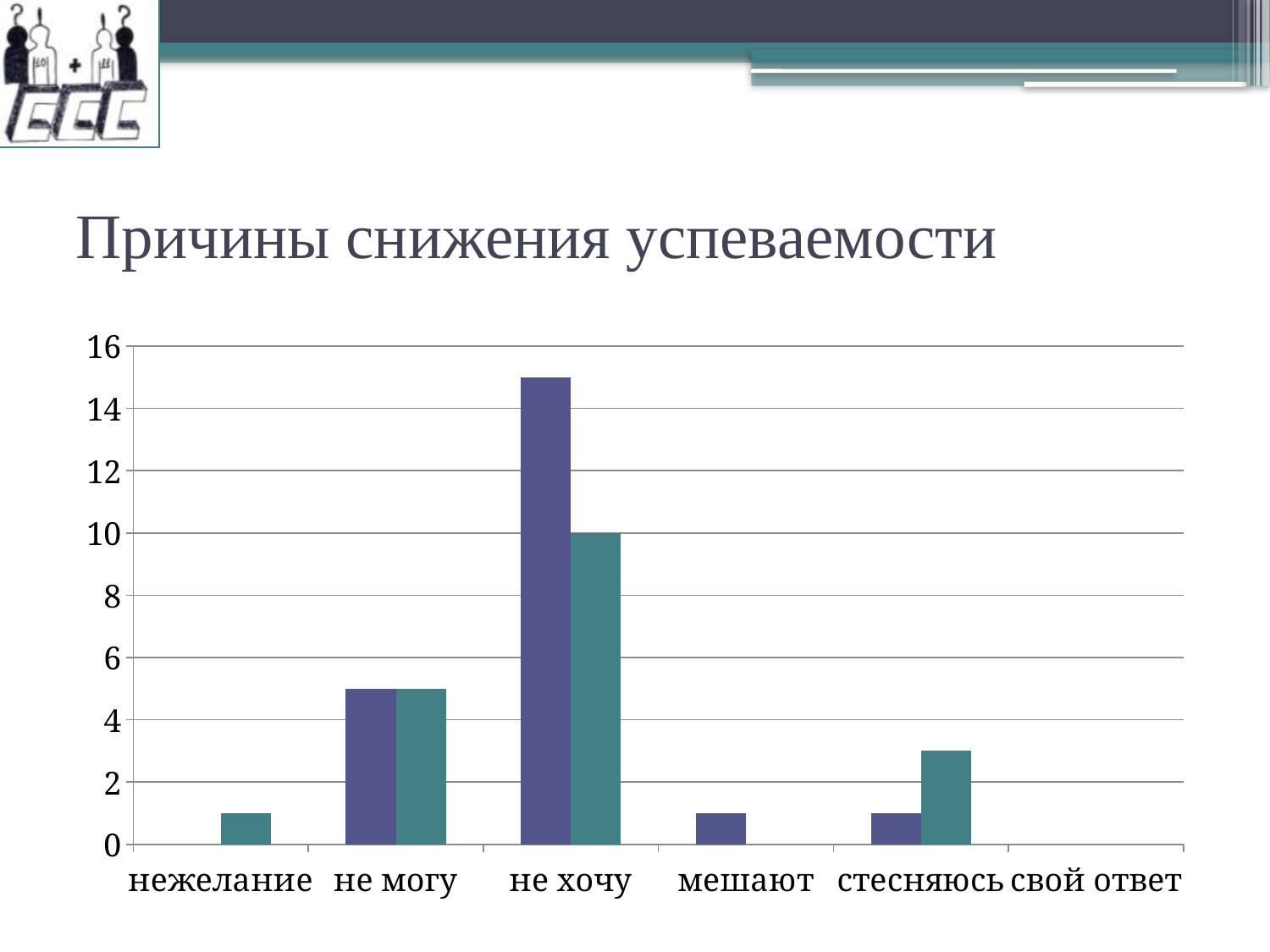
What is the title of the chart? Причины снижения успеваемости How many categories are shown on the x axis of the chart? 6 Is the value of the purple bar for "не хочу" greater or less than 14? greater Is the value of the teal bar for "нежелание" greater or less than 2? less Which has the taller purple bar, "не могу" or "мешают"? не могу For "стесняюсь", which bar is taller, the purple one or the teal one? the teal one What kind of chart is shown on the slide? bar chart Is the value of the purple bar for "не могу" greater or less than 4? greater What is the value of the teal bar for "не хочу"? 10 For "не хочу", which bar is taller, the purple one or the teal one? the purple one Which category has the tallest bar in the chart? не хочу